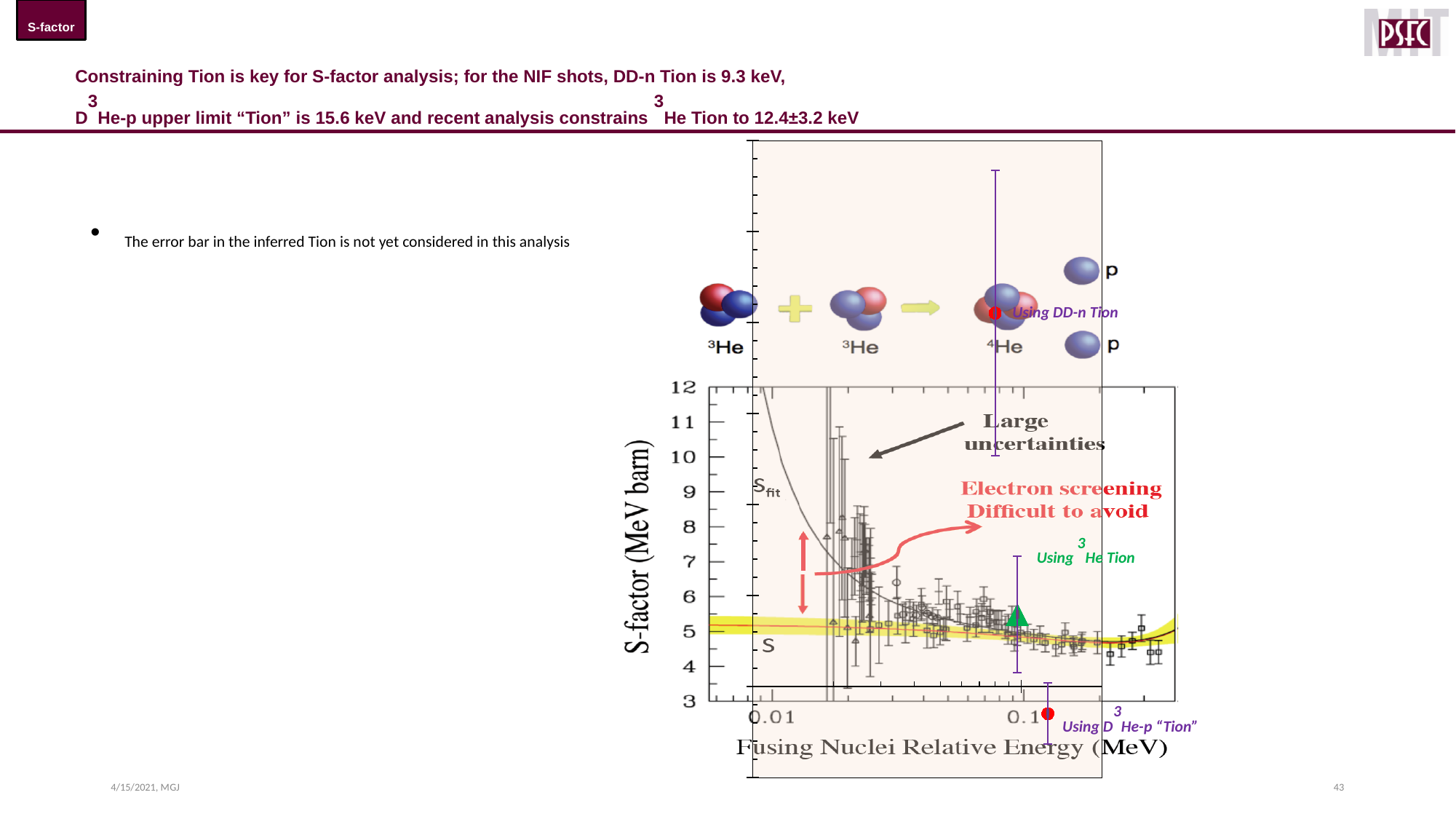
What is the label of the y-axis of the chart? S-factor (MeV barn) What is the label of the x-axis of the chart? Fusing Nuclei Relative Energy (MeV) Which of the three overlaid NIF points (Using DD-n Tion, Using 3He Tion, Using D3He-p Tion) has the lowest S-factor value? Using D3He-p Tion Which of the three overlaid NIF points (Using DD-n Tion, Using 3He Tion, Using D3He-p Tion) has the highest S-factor value? Using DD-n Tion Is the S-factor value of the red point labelled "Using D3He-p Tion" greater or less than 3? less Is the S-factor value of the green triangle labelled "Using 3He Tion" greater or less than 6? less What is the lowest value labelled on the y-axis of the chart? 3 What kind of chart is shown on the slide? Scatter plot What is the highest value labelled on the y-axis of the chart? 12 Does the S_fit curve rise or fall as the fusing nuclei relative energy increases along the x-axis? fall